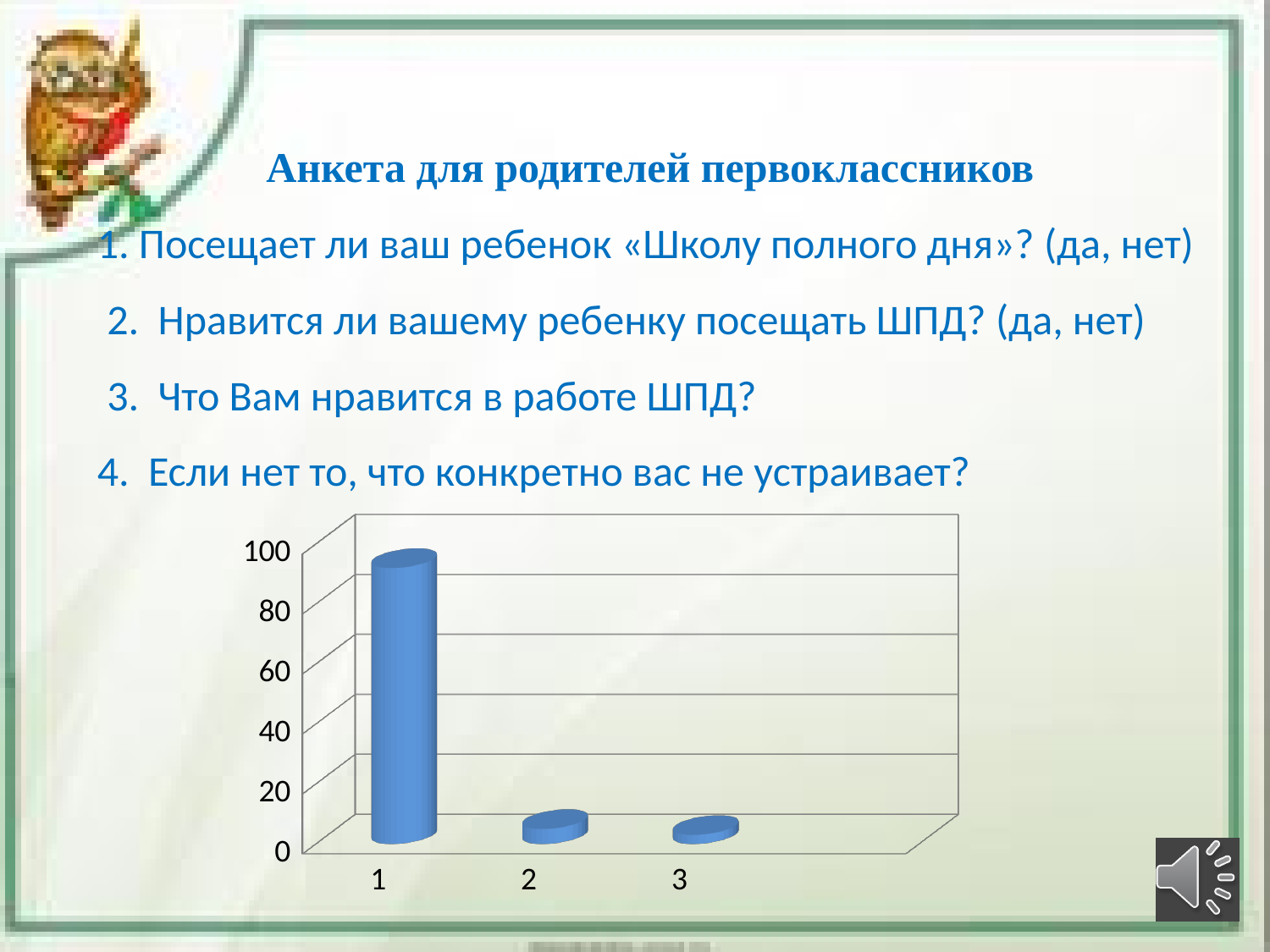
What colour are the bars in the chart? blue Is the value for category 2 greater or less than 20? less What kind of chart is shown on the slide? bar chart Which is larger, the value for category 3 or the value for category 1? category 1 Which is larger, the value for category 1 or the value for category 2? category 1 Is the value for category 3 greater or less than 20? less Is the value for category 1 greater or less than 80? greater How many categories are shown on the x axis of the chart? 3 Does the value rise or fall from category 1 to category 2? fall What is the highest value shown on the vertical axis of the chart? 100 Which category has the highest bar in the chart? 1